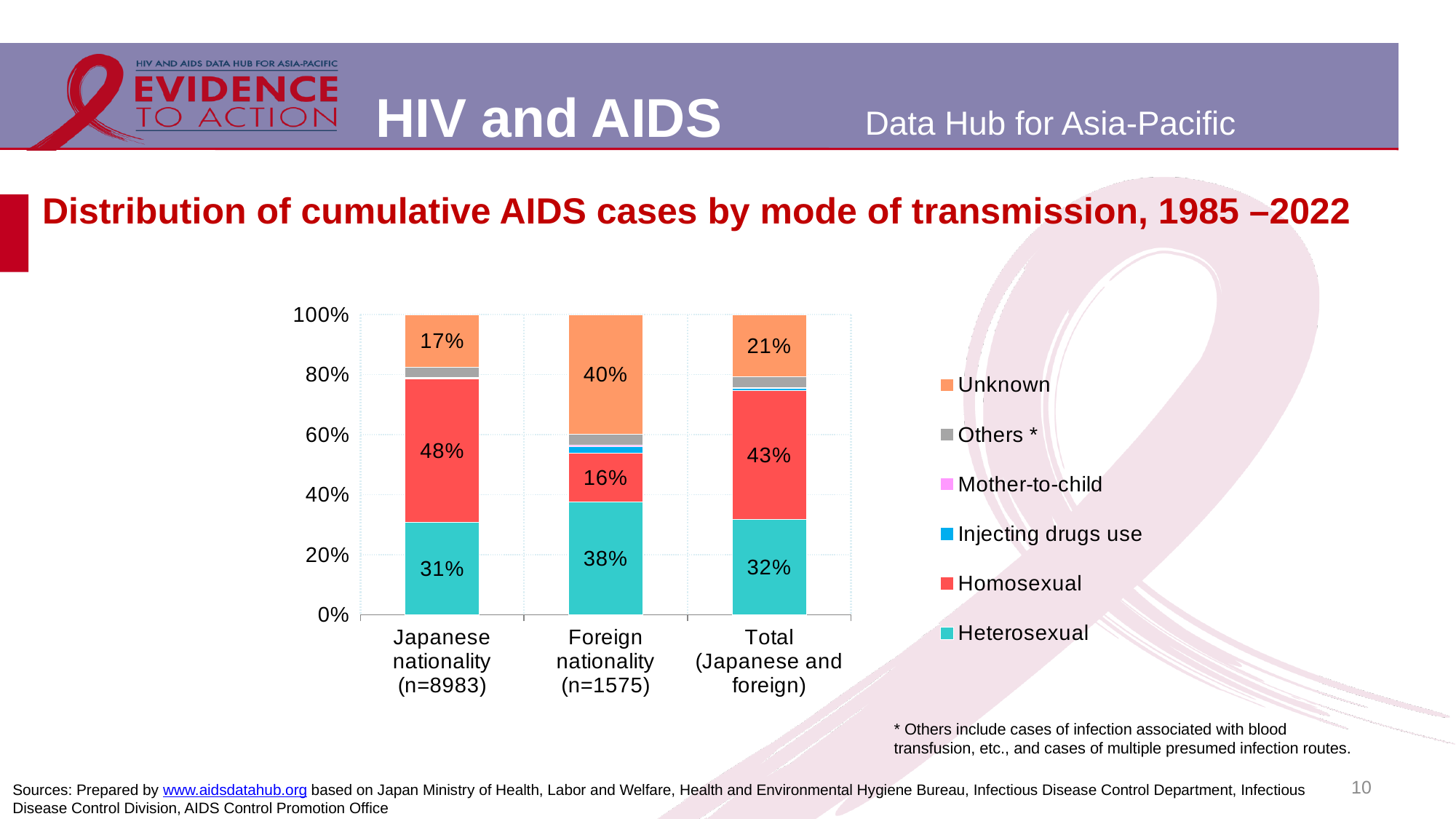
What share of cumulative AIDS cases among Japanese nationality is attributed to Homosexual transmission? 48% What type of chart is used on this slide? Stacked bar chart What is the Heterosexual share for the Total (Japanese and foreign) bar? 32% Is the Others * share for Japanese nationality greater or less than 20%? less Is the Unknown share larger for Japanese nationality or for Foreign nationality? Foreign nationality Which colour represents Heterosexual transmission in the chart? Teal How many modes of transmission does the legend list? 6 Which nationality group has the highest Homosexual share? Japanese nationality (n=8983) How many bars (categories) are shown on the chart? 3 What share of cumulative AIDS cases among Foreign nationality is attributed to Unknown mode of transmission? 40% Which of the three bars has the lowest Heterosexual share? Japanese nationality (n=8983) What is the difference in percentage points between the Homosexual share for Japanese nationality and for Foreign nationality? 32 percentage points